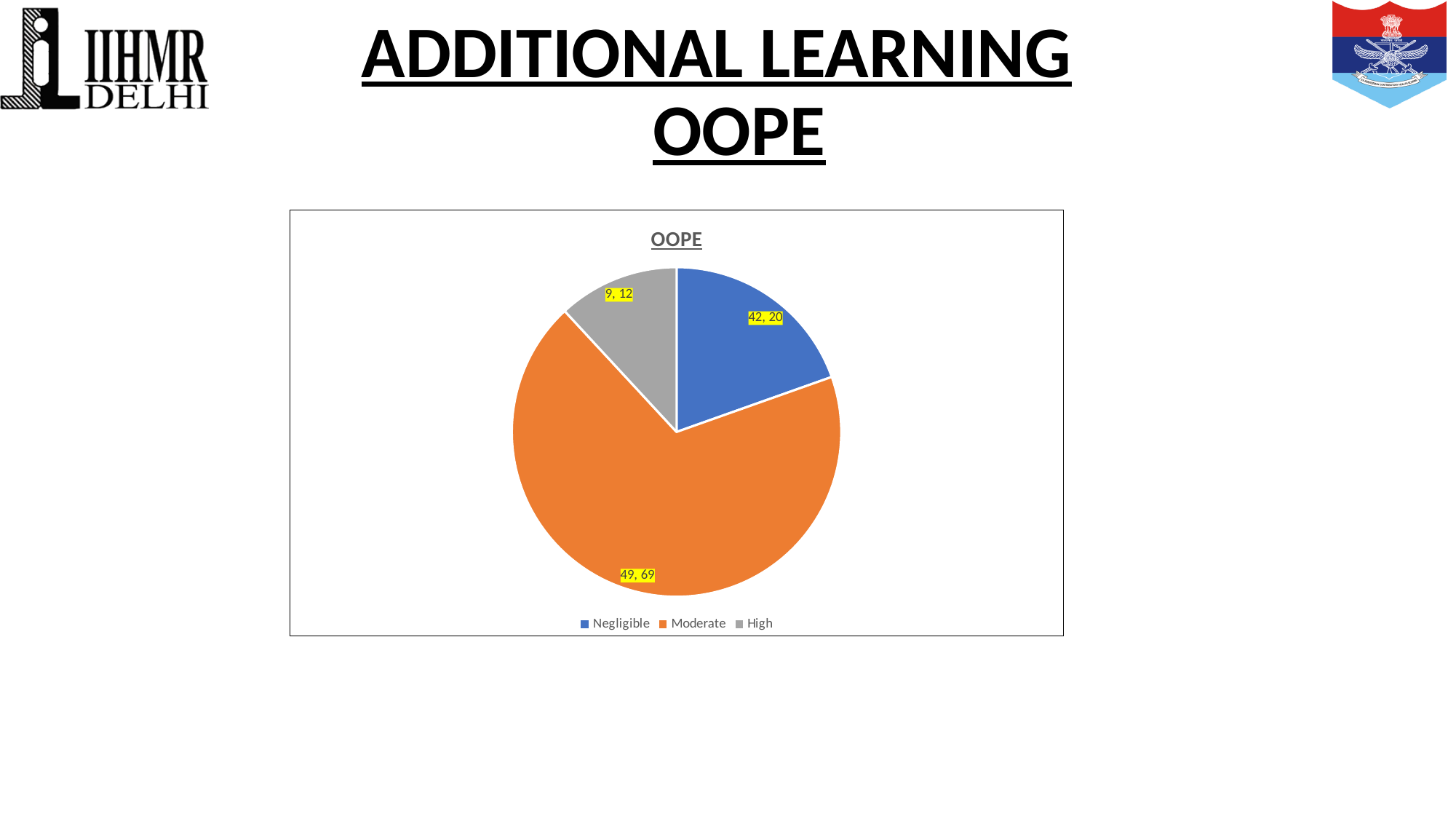
Which slice is larger, Negligible or High? Negligible Which slice is larger, Moderate or Negligible? Moderate What colour is the Moderate slice? orange Which category has the smallest slice of the pie? High How many slices does the pie chart have? 3 Which category has the largest slice of the pie? Moderate How many entries does the legend list? 3 What kind of chart is shown on the slide? pie chart What data label is printed on the Negligible slice? 42, 20 What data label is printed on the Moderate slice? 49, 69 What is the title of the chart? OOPE What data label is printed on the High slice? 9, 12